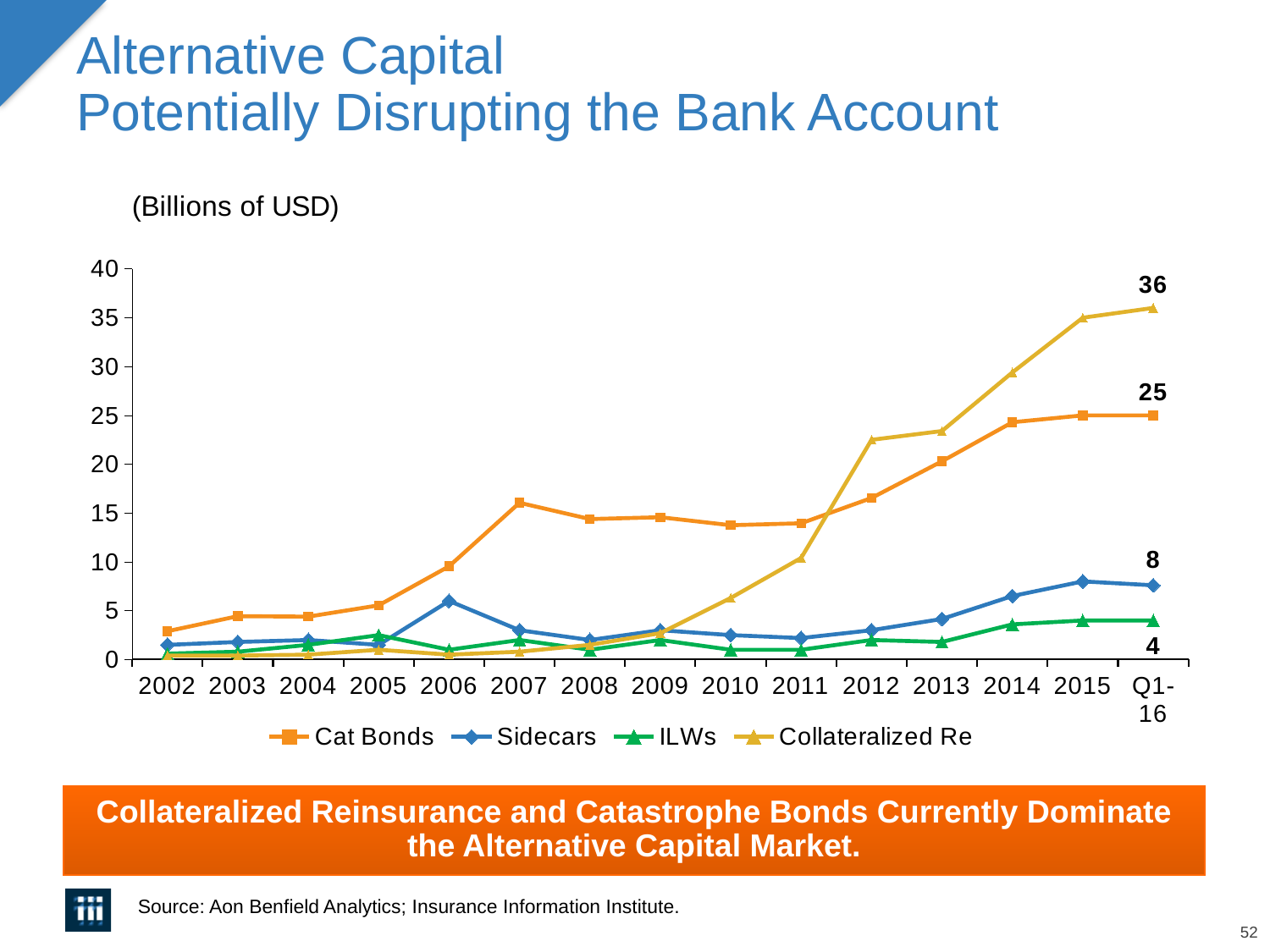
What is the value for Sidecars at Q1-16? 8 Which series has the highest value at Q1-16? Collateralized Re Which series has the lowest value at Q1-16? ILWs What is the value for Cat Bonds at Q1-16? 25 What is the value for Collateralized Re at Q1-16? 36 How many series does the legend list? 4 How many time periods are shown on the x axis? 15 What is the difference between the Collateralized Re and Cat Bonds values at Q1-16? 11 What type of chart is shown on the slide? line chart Does the Collateralized Re series rise or fall from 2011 to 2015? rise Is the value for Cat Bonds in 2007 greater or less than 15? greater What is the value for ILWs at Q1-16? 4